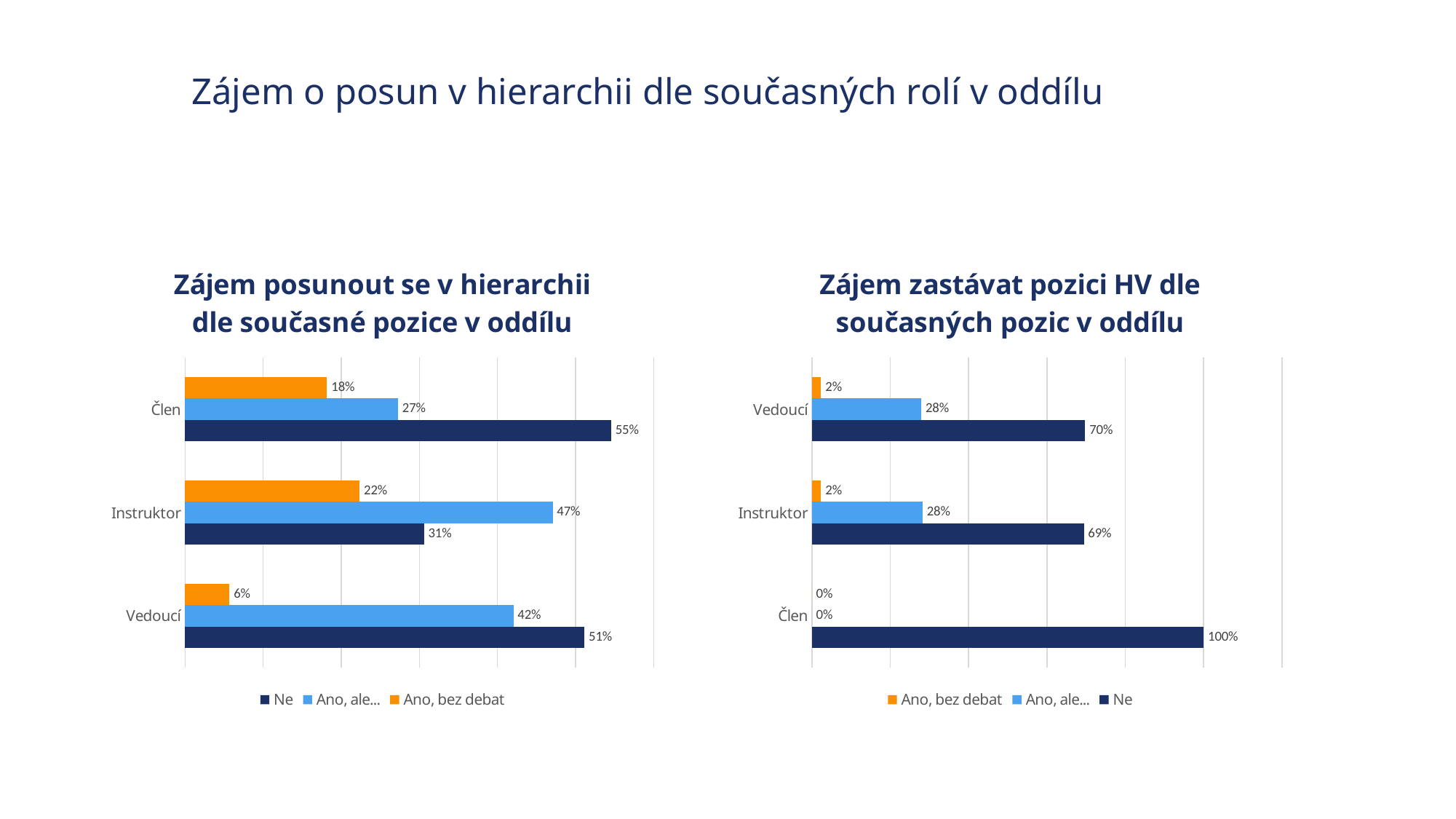
How many categories are shown in the right chart (Zájem zastávat pozici HV dle současných pozic v oddílu)? 3 What kind of chart is the right chart (Zájem zastávat pozici HV dle současných pozic v oddílu)? Bar chart In the left chart (Zájem posunout se v hierarchii dle současné pozice v oddílu), what is the difference between the Ne values for Člen and Vedoucí? 4% In the right chart (Zájem zastávat pozici HV dle současných pozic v oddílu), what is the value of the Ano, bez debat series for Vedoucí? 2% In the right chart (Zájem zastávat pozici HV dle současných pozic v oddílu), what is the difference between the Ne values for Vedoucí and Instruktor? 1% In the left chart (Zájem posunout se v hierarchii dle současné pozice v oddílu), which category has the highest value in the Ano, bez debat series? Instruktor In the left chart (Zájem posunout se v hierarchii dle současné pozice v oddílu), what is the value of the Ano, bez debat series for Vedoucí? 6% In the left chart (Zájem posunout se v hierarchii dle současné pozice v oddílu), what is the value of the Ne series for Člen? 55% In the left chart (Zájem posunout se v hierarchii dle současné pozice v oddílu), which is larger for Instruktor: the Ne value or the Ano, bez debat value? Ne In the left chart (Zájem posunout se v hierarchii dle současné pozice v oddílu), which category has the lowest value in the Ne series? Instruktor How many series does the legend of the left chart (Zájem posunout se v hierarchii dle současné pozice v oddílu) list? 3 In the right chart (Zájem zastávat pozici HV dle současných pozic v oddílu), what is the value of the Ne series for Člen? 100%